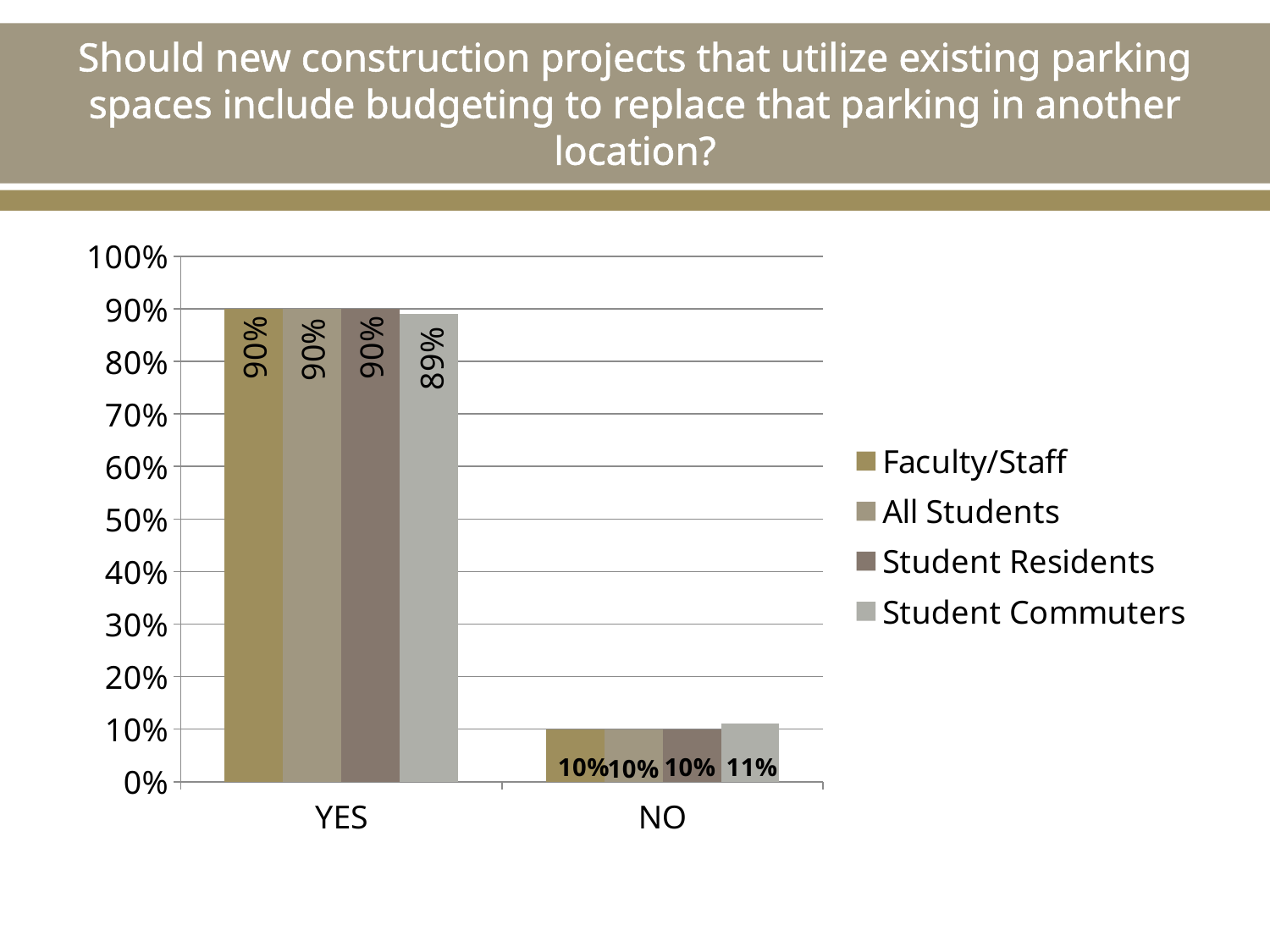
How many response categories are shown on the x axis? 2 Is the YES value for Faculty/Staff greater or less than the NO value for Faculty/Staff? greater What percentage of Faculty/Staff answered YES? 90% Which group has the highest NO percentage? Student Commuters What percentage of Student Commuters answered YES? 89% How many series does the legend list? 4 What percentage of Student Commuters answered NO? 11% What percentage of Student Residents answered NO? 10% What is the difference between the YES and NO percentages for All Students? 80% Is the NO value for Student Commuters greater or less than 50%? less Which group has the lowest YES percentage? Student Commuters What kind of chart is shown on the slide? bar chart